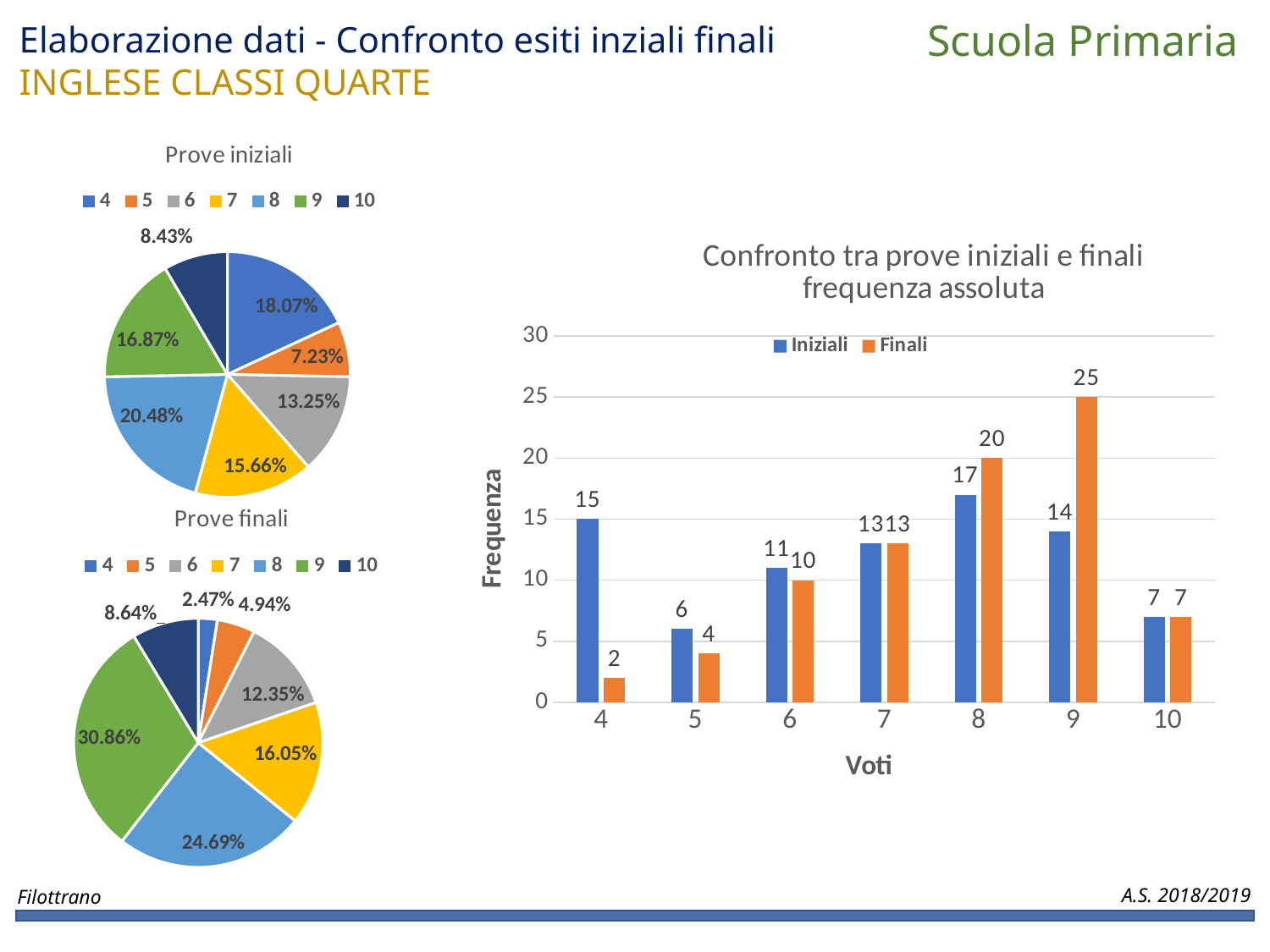
In the 'Confronto tra prove iniziali e finali frequenza assoluta' chart, which voto has the highest Finali value? 9 In the 'Confronto tra prove iniziali e finali frequenza assoluta' chart, which voto has the lowest Iniziali value? 5 In the 'Confronto tra prove iniziali e finali frequenza assoluta' chart, what is the difference between the Finali and Iniziali values for voto 8? 3 In the 'Prove finali' pie chart, which voto has the smallest slice? 4 How many slices does the 'Prove iniziali' pie chart have? 7 In the 'Prove finali' pie chart, what is the share for voto 9? 30.86% In the 'Confronto tra prove iniziali e finali frequenza assoluta' chart, what is the Iniziali value for voto 4? 15 In the 'Confronto tra prove iniziali e finali frequenza assoluta' chart, which is larger for voto 6, Iniziali or Finali? Iniziali In the 'Prove iniziali' pie chart, what is the share for voto 8? 20.48% How many series does the legend of the 'Confronto tra prove iniziali e finali frequenza assoluta' chart list? 2 What kind of chart is 'Confronto tra prove iniziali e finali frequenza assoluta'? Bar chart In the 'Confronto tra prove iniziali e finali frequenza assoluta' chart, what is the Finali value for voto 9? 25